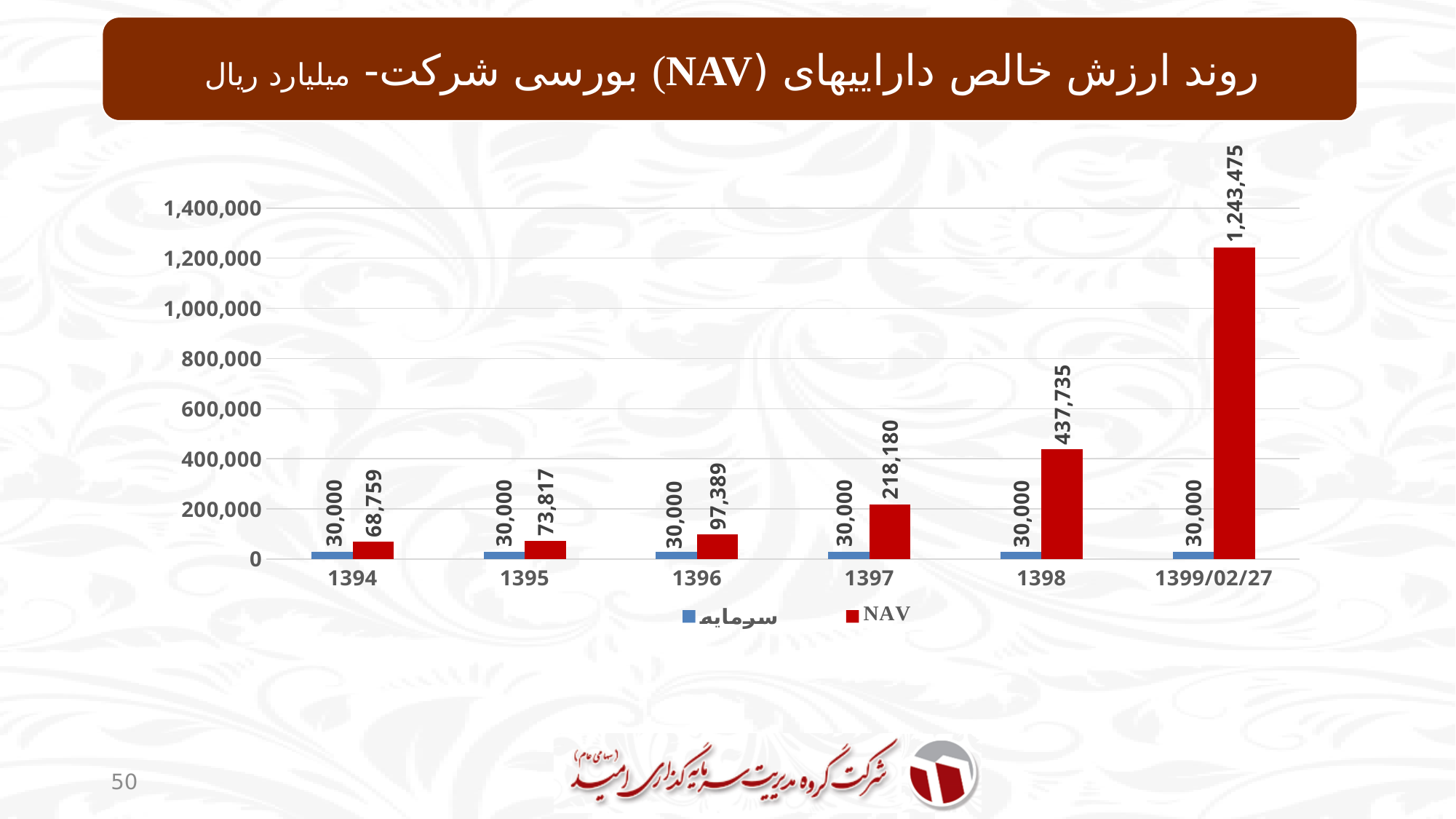
Which is larger, the NAV value for 1396 or the NAV value for 1395? 1396 Is the NAV value for 1398 greater or less than 400,000? greater What is the difference between the NAV values for 1398 and 1397? 219,555 What is the NAV value for 1399/02/27? 1,243,475 How many series does the legend list? 2 Which category has the highest NAV value? 1399/02/27 What is the value of the سرمایه series for 1396? 30,000 Which category has the lowest NAV value? 1394 How many categories are shown on the x axis? 6 What kind of chart is shown on the slide? bar chart What is the difference between the NAV value and the سرمایه value for 1395? 43,817 What is the NAV value for 1397? 218,180